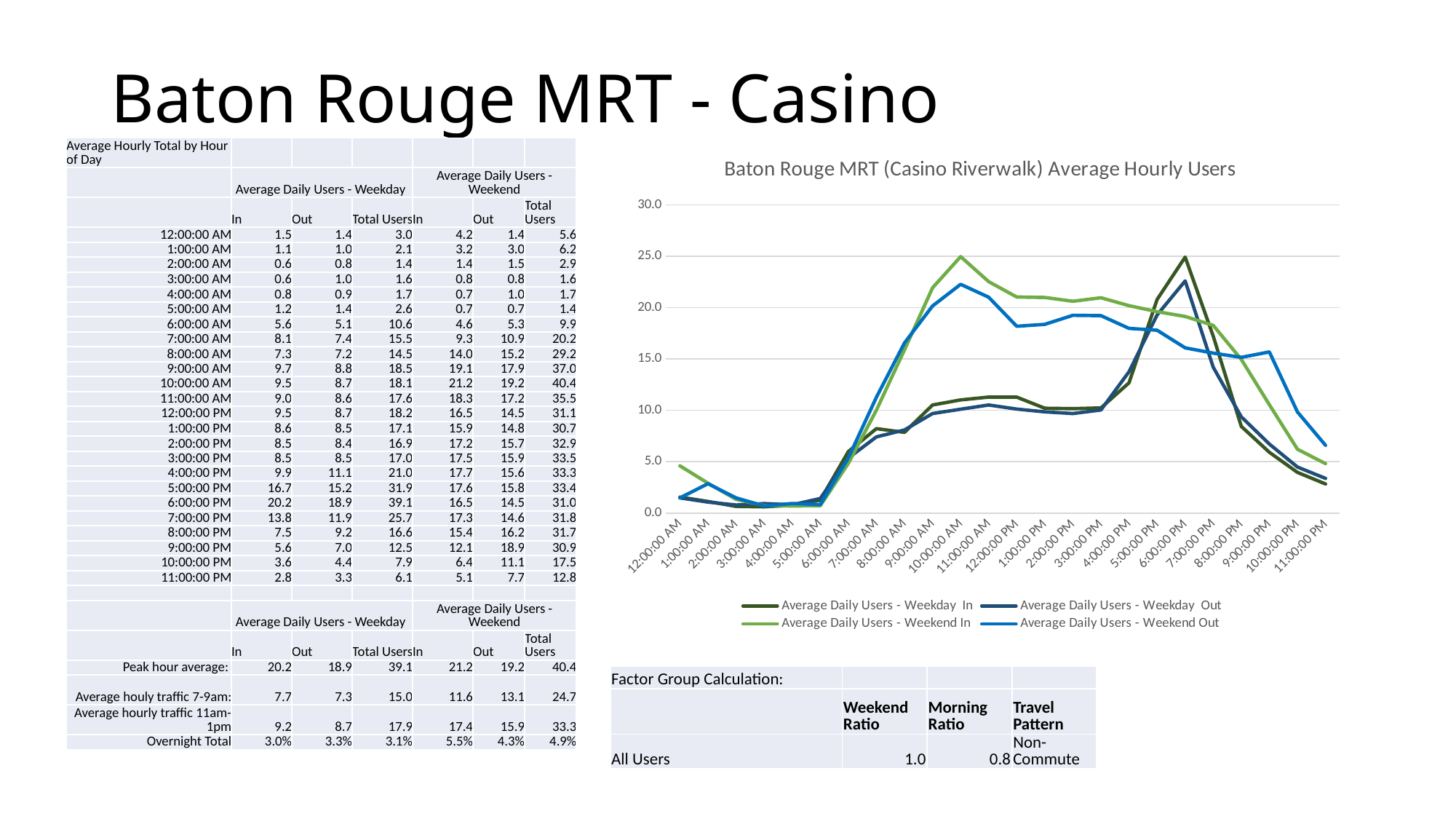
Is the value for Average Daily Users - Weekend In at 10:00:00 AM greater or less than 20.0? greater How many series does the chart legend list? 4 What is the title of the chart? Baton Rouge MRT (Casino Riverwalk) Average Hourly Users What type of chart is shown on the slide? line chart How many hourly points are plotted along the x axis of the chart? 24 Is the value for Average Daily Users - Weekday In at 6:00:00 PM greater or less than 20.0? greater Is the value for Average Daily Users - Weekday In at 3:00:00 AM greater or less than 5.0? less At which hour does the Average Daily Users - Weekday In series reach its highest value? 6:00:00 PM Does the Average Daily Users - Weekend In series generally rise or fall from 10:00:00 AM to 11:00:00 PM? fall At 6:00:00 PM, which is larger: Average Daily Users - Weekday In or Average Daily Users - Weekend In? Average Daily Users - Weekday In At 10:00:00 AM, which is larger: Average Daily Users - Weekend In or Average Daily Users - Weekday In? Average Daily Users - Weekend In At which hour does the Average Daily Users - Weekend In series reach its highest value? 10:00:00 AM